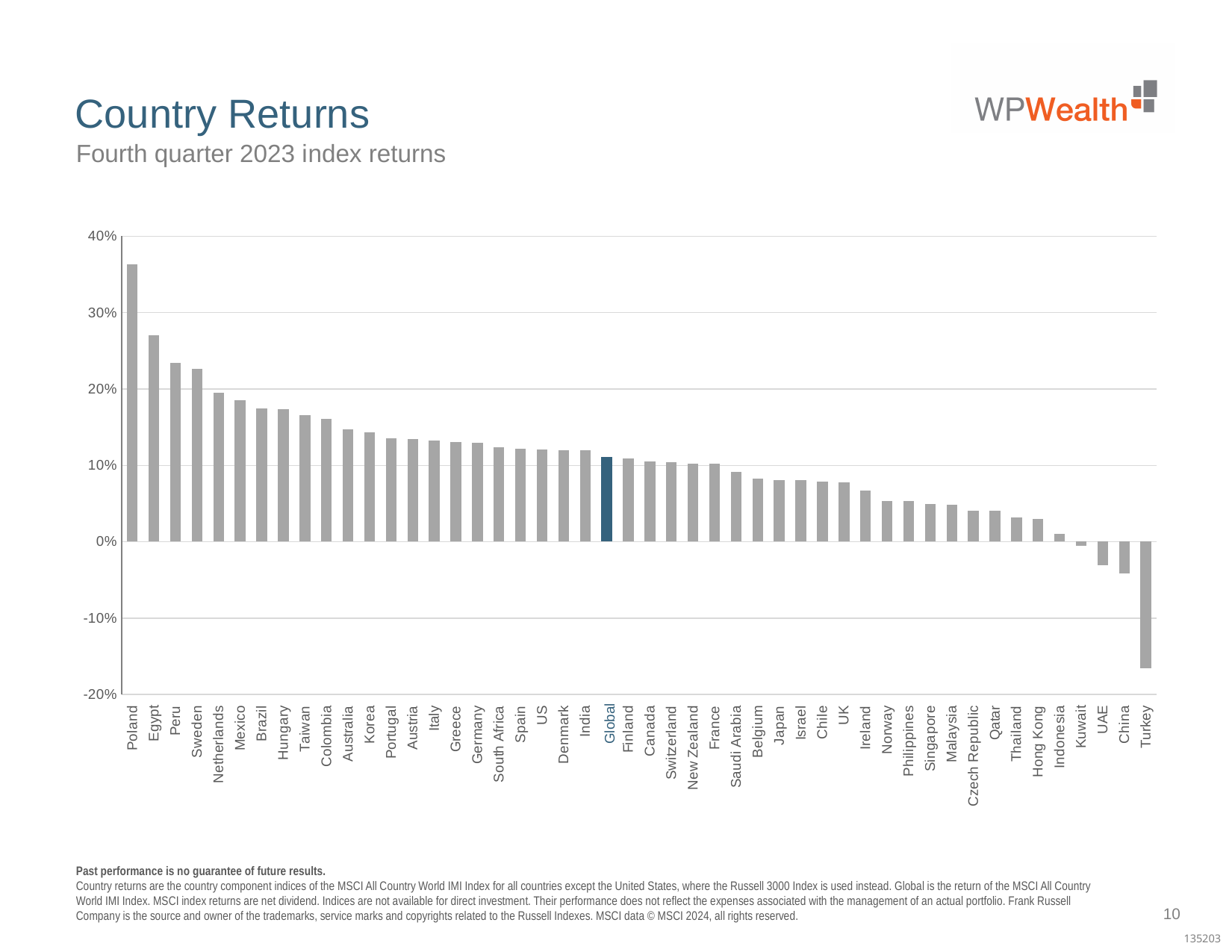
Is the value for Egypt greater or less than 20%? greater Do the values generally rise or fall moving from left to right along the x axis? Fall Is the value for Poland greater or less than 30%? greater Which has the larger return, Egypt or Peru? Egypt Is the value for Turkey greater or less than -10%? less How many bars (countries plus Global) are plotted in the chart? 48 Which bar is highlighted in a different colour (dark blue) from the others? Global Which country has the lowest fourth quarter 2023 return? Turkey Which country has the highest fourth quarter 2023 return? Poland What kind of chart is shown on the slide? Bar chart